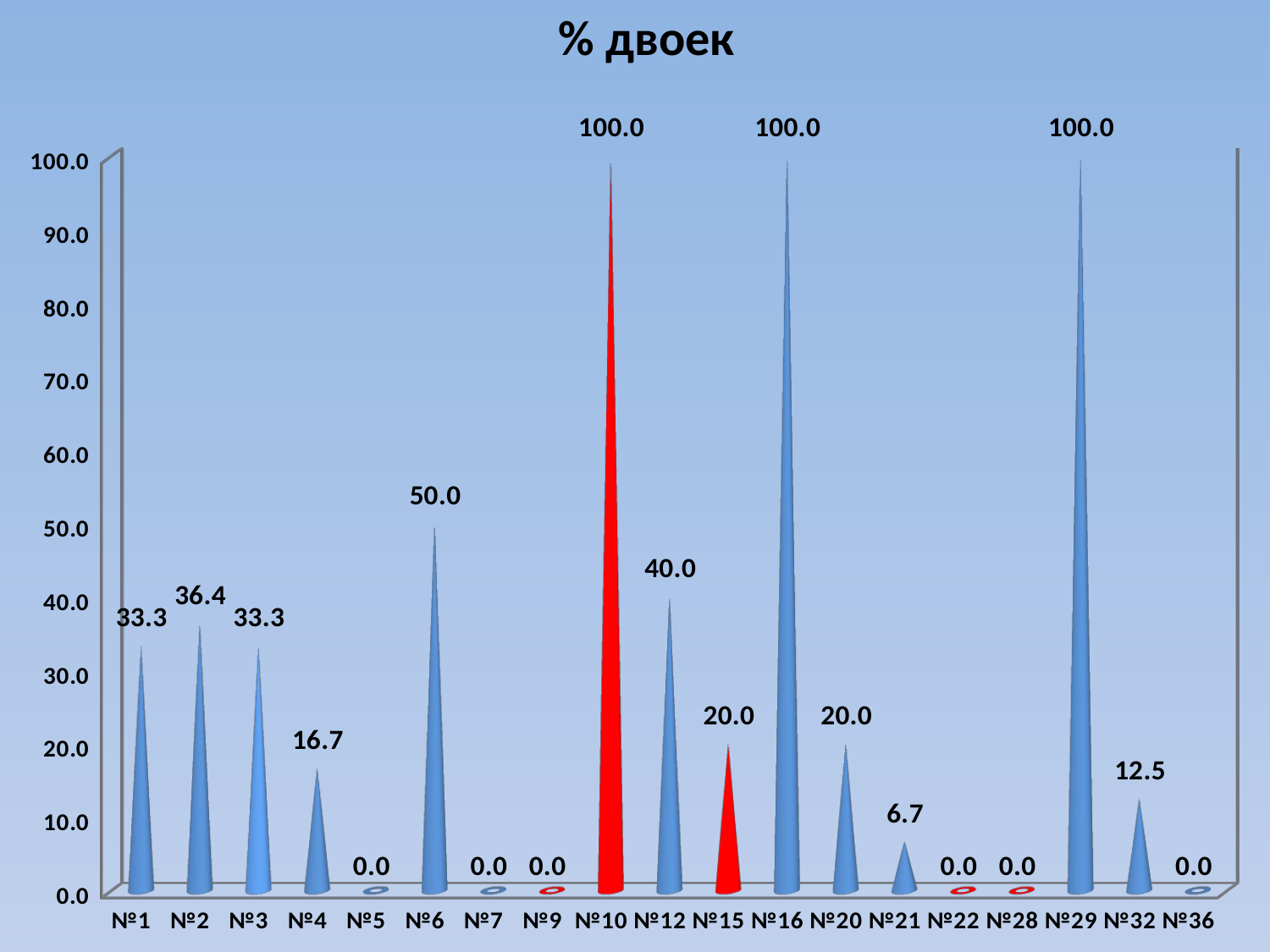
Is the value for №12 greater or less than 30.0? greater Which has the larger value, №4 or №15? №15 What kind of chart is shown on the slide? bar chart What is the difference between the values for №6 and №12? 10.0 What is the highest value shown on the chart? 100.0 What is the difference between the values for №2 and №1? 3.1 What is the value for №21? 6.7 What is the value for №2? 36.4 What is the value for №4? 16.7 What is the value for №6? 50.0 What is the value for №32? 12.5 How many categories are shown on the x axis? 19